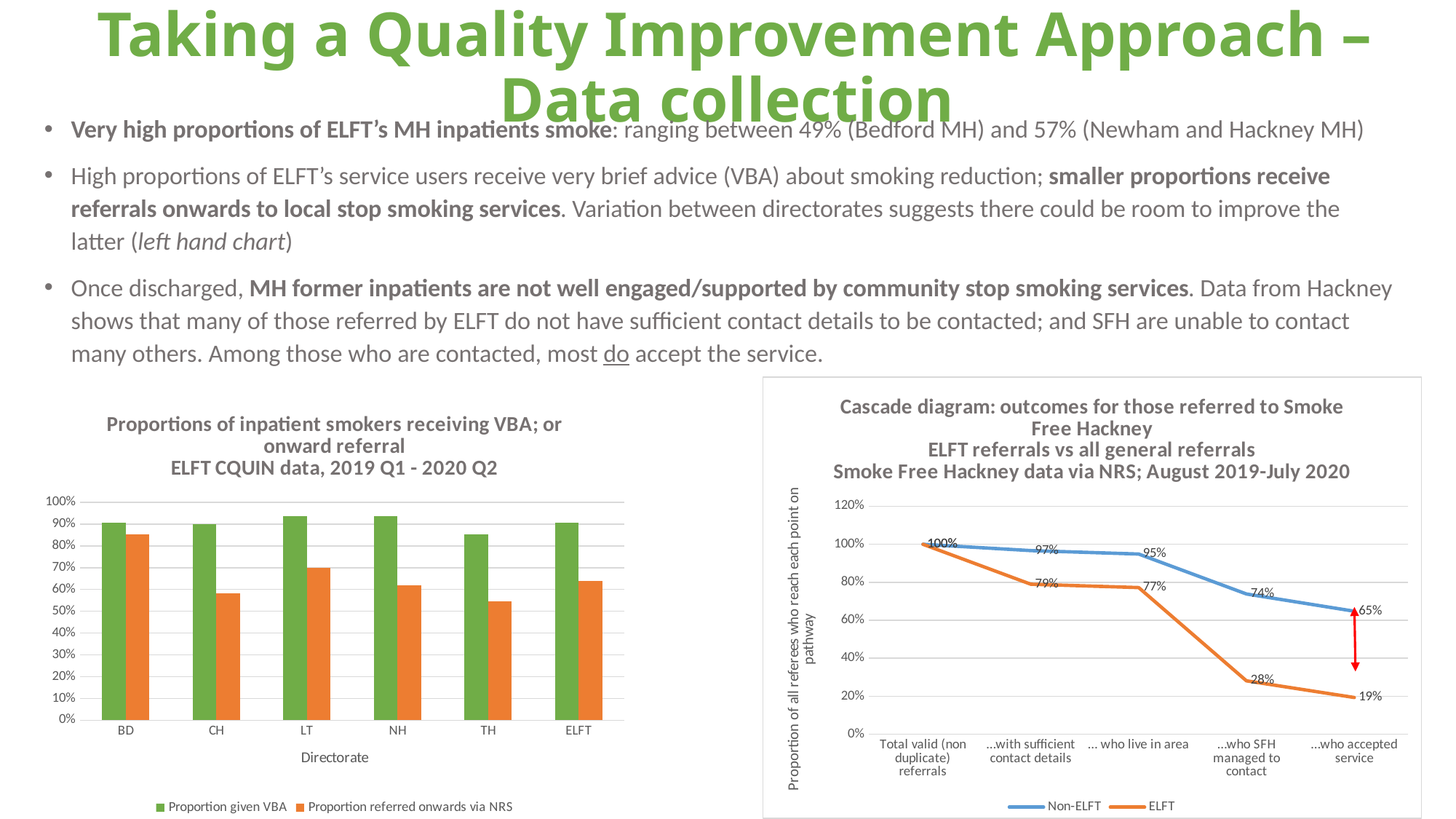
In the Cascade diagram chart on the right, what is the Non-ELFT value for '...who SFH managed to contact'? 74% How many directorate categories are shown on the x axis of the left-hand bar chart? 6 In the left-hand bar chart, which is larger for LT: the 'Proportion given VBA' or the 'Proportion referred onwards via NRS'? Proportion given VBA What kind of chart is the 'Proportions of inpatient smokers receiving VBA; or onward referral' chart on the left? Bar chart In the Cascade diagram chart on the right, do the ELFT values rise or fall along the x axis? Fall How many series does the legend of the Cascade diagram chart on the right list? 2 In the left-hand bar chart, which directorate has the highest 'Proportion referred onwards via NRS'? BD What kind of chart is the Cascade diagram on the right? Line chart In the Cascade diagram chart on the right, what is the difference between the Non-ELFT and ELFT values at '...who accepted service'? 46 percentage points In the Cascade diagram chart on the right, what is the ELFT value for '...who accepted service'? 19% In the Cascade diagram chart on the right, which series has the higher value at '...with sufficient contact details', Non-ELFT or ELFT? Non-ELFT In the left-hand bar chart, is the 'Proportion referred onwards via NRS' for TH greater or less than 60%? less